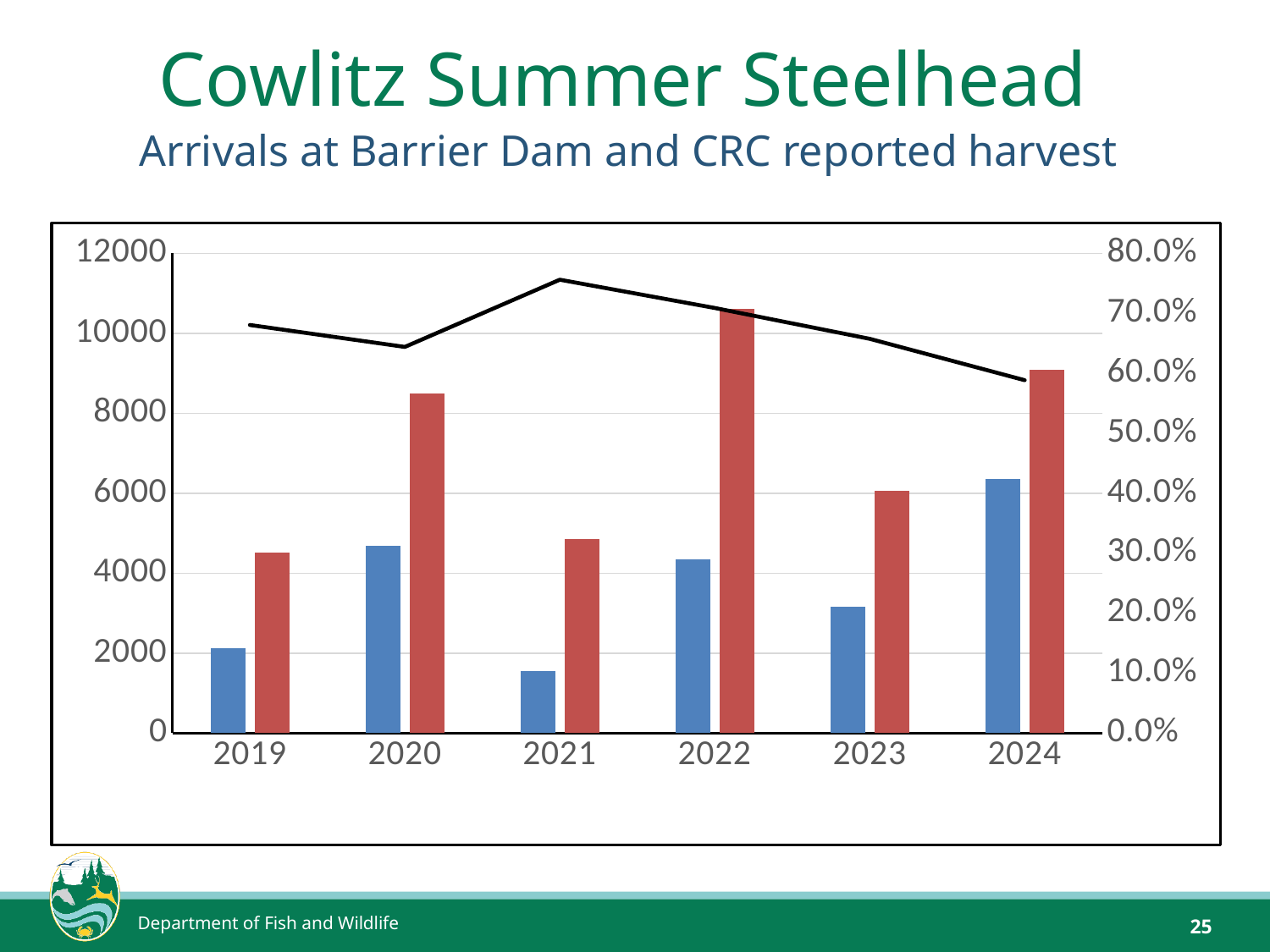
In which year does the black line reach its lowest point? 2024 Which is larger, the red bar for 2020 or the red bar for 2024? 2024 In which year is the blue bar the tallest? 2024 Is the value of the blue bar for 2021 greater or less than 2000? less In which year is the blue bar the shortest? 2021 Is the value of the red bar for 2022 greater or less than 10000? greater Is the value of the black line for 2021 greater or less than 70.0%? greater In which year does the black line reach its highest point? 2021 In which year is the red bar the tallest? 2022 Does the black line rise or fall from 2022 to 2024? fall How many years are shown on the x axis of the chart? 6 What kind of chart is shown on the slide? Bar chart with a line